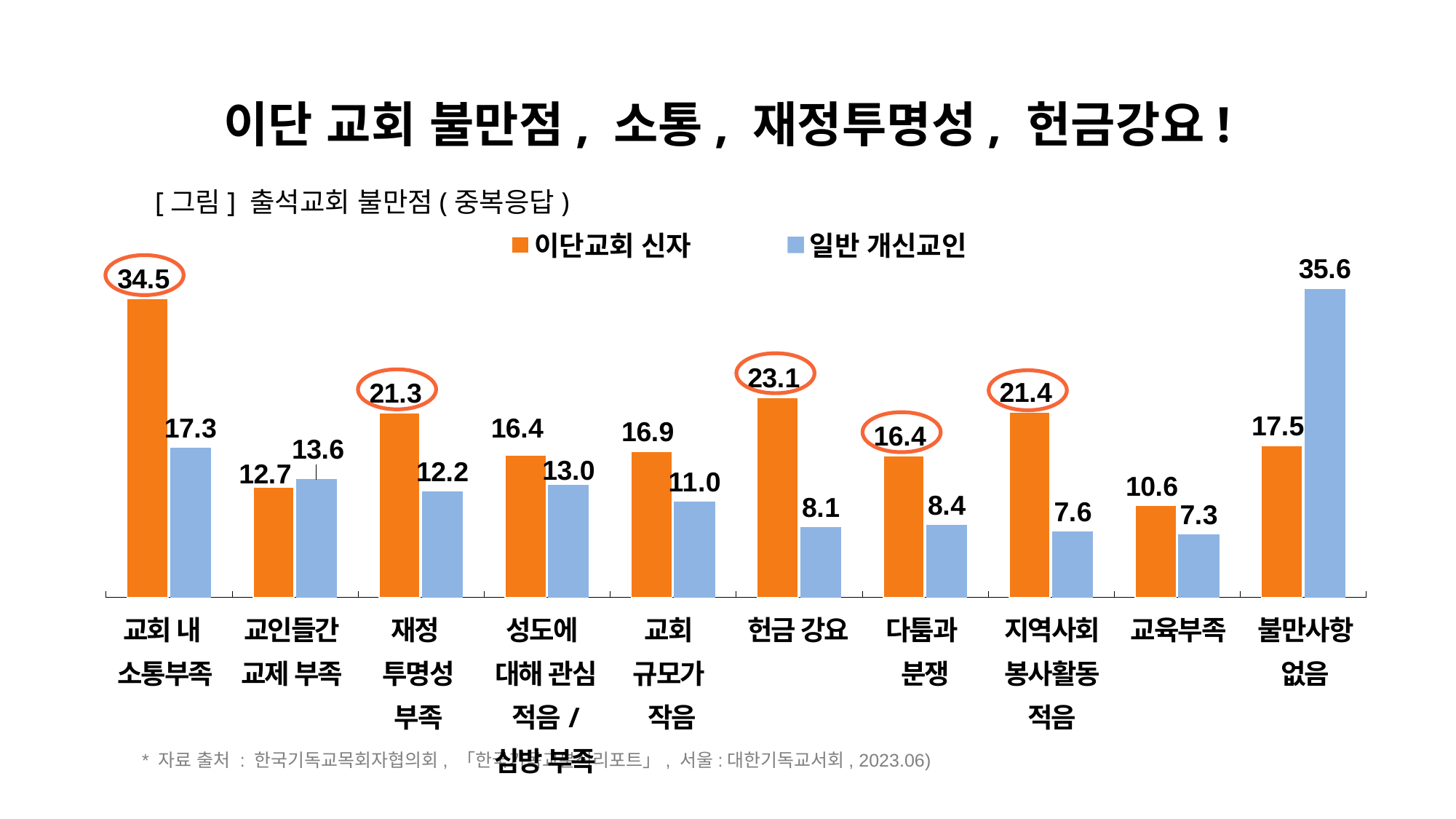
Which colour represents the 일반 개신교인 series in the chart? blue Which category has the lowest value for the 일반 개신교인 series? 교육부족 Which category has the highest value for the 이단교회 신자 series? 교회 내 소통부족 What is the value for 일반 개신교인 in the 불만사항 없음 category? 35.6 What is the difference between the 이단교회 신자 and 일반 개신교인 values in the 재정 투명성 부족 category? 9.1 In the 교인들간 교제 부족 category, which series has the larger value, 이단교회 신자 or 일반 개신교인? 일반 개신교인 What is the value for 일반 개신교인 in the 헌금 강요 category? 8.1 What is the value for 이단교회 신자 in the 지역사회 봉사활동 적음 category? 21.4 What is the value for 이단교회 신자 in the 교회 내 소통부족 category? 34.5 How many series does the legend list? 2 How many categories are shown on the x axis of the chart? 10 What kind of chart is shown on the slide? bar chart